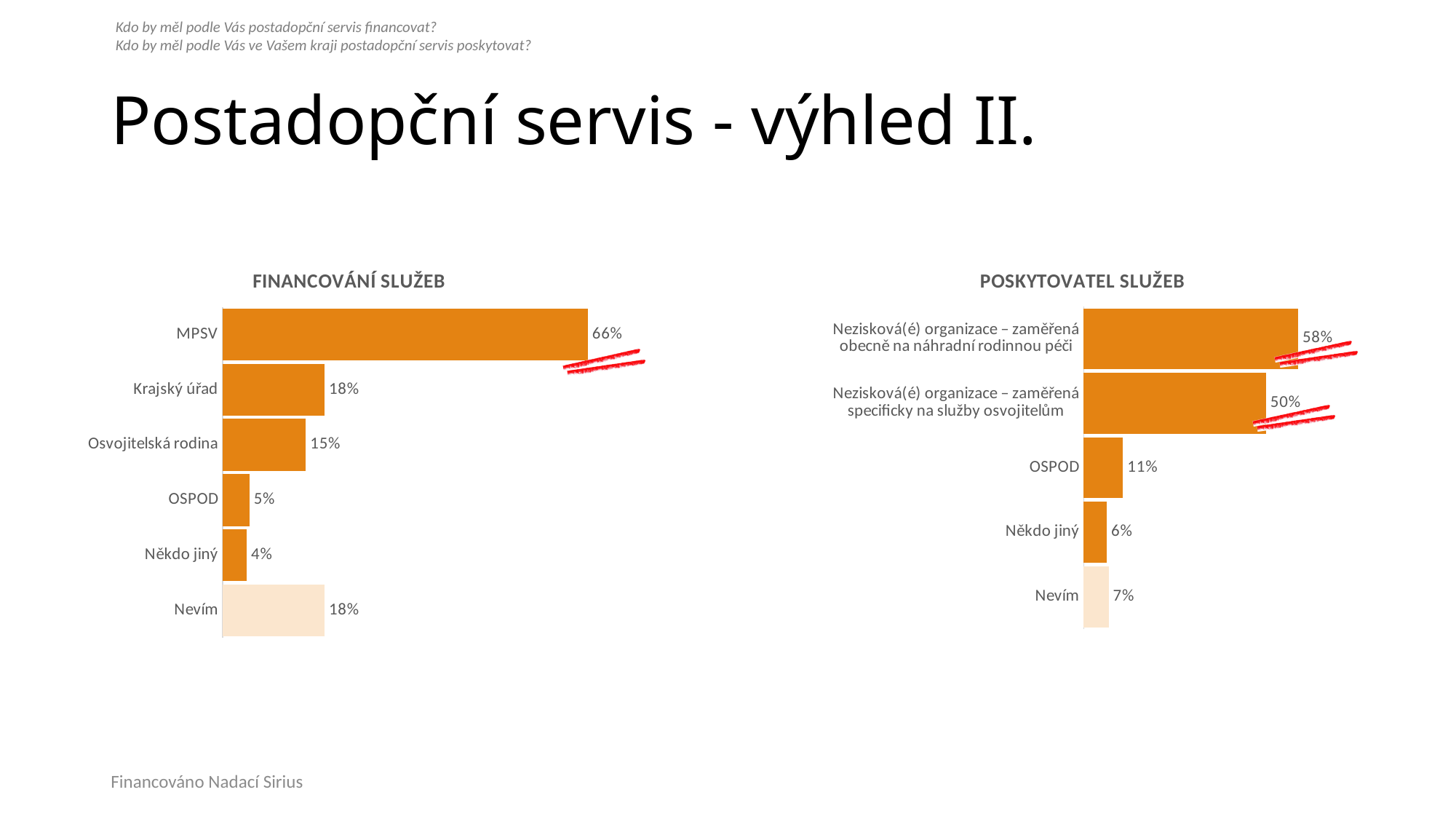
In the FINANCOVÁNÍ SLUŽEB chart, how many categories are shown? 6 In the POSKYTOVATEL SLUŽEB chart, how many categories are shown? 5 In the POSKYTOVATEL SLUŽEB chart, what is the value for OSPOD? 11% What type of chart is the POSKYTOVATEL SLUŽEB chart? Bar chart In the FINANCOVÁNÍ SLUŽEB chart, what is the value for Osvojitelská rodina? 15% In the FINANCOVÁNÍ SLUŽEB chart, what is the difference between MPSV and Krajský úřad? 48% In the POSKYTOVATEL SLUŽEB chart, what is the difference between the two Nezisková(é) organizace categories? 8% In the FINANCOVÁNÍ SLUŽEB chart, which category has the lowest value? Někdo jiný In the FINANCOVÁNÍ SLUŽEB chart, which is larger, OSPOD or Někdo jiný? OSPOD In the POSKYTOVATEL SLUŽEB chart, what is the value for Nevím? 7% In the POSKYTOVATEL SLUŽEB chart, which category has the highest value? Nezisková(é) organizace – zaměřená obecně na náhradní rodinnou péči In the FINANCOVÁNÍ SLUŽEB chart, what is the value for MPSV? 66%